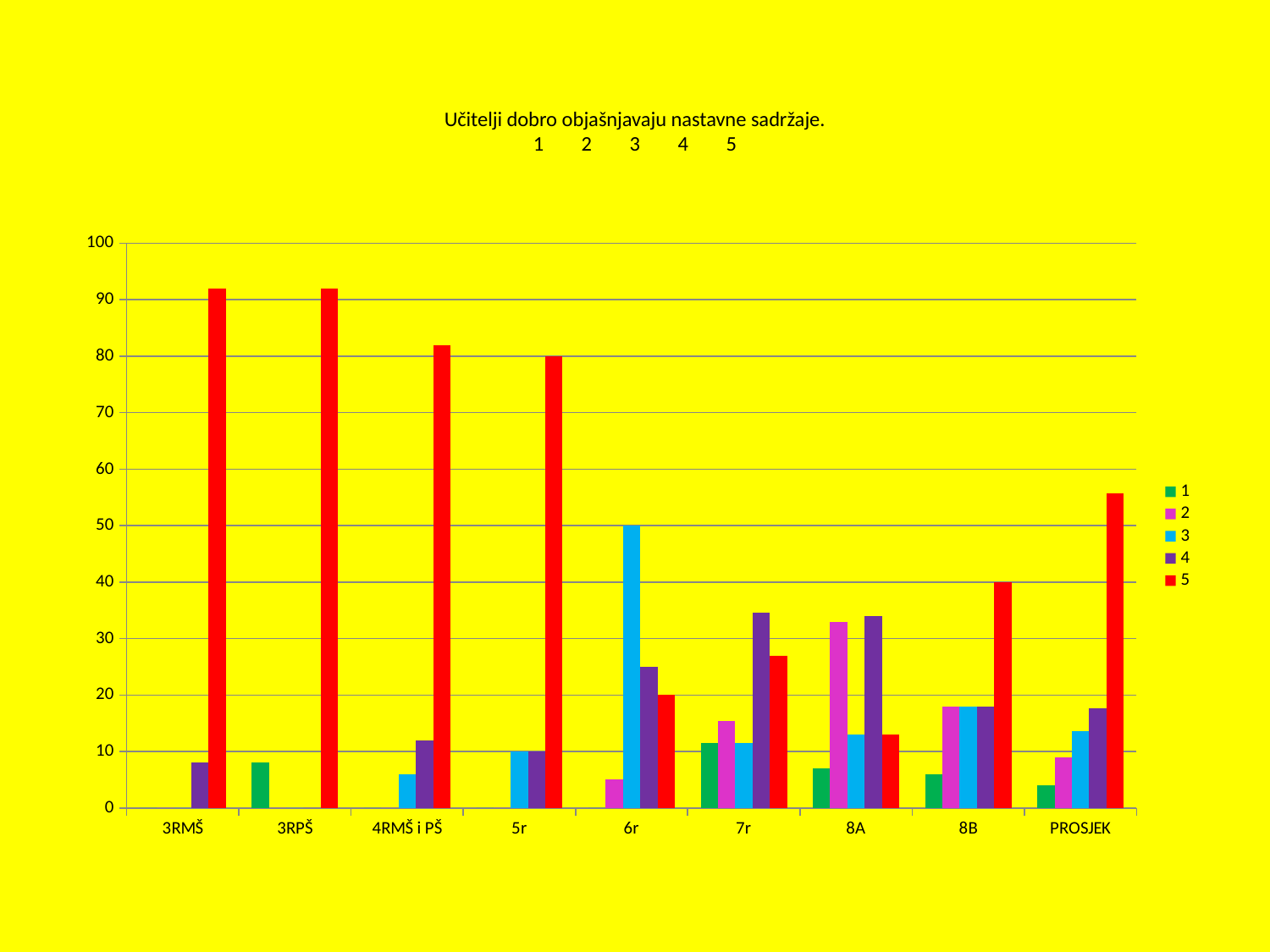
What is the value of series 5 for 5r? 80 Is the value of series 2 for 8A greater or less than 30? greater Which category has the lowest value for series 5? 8A What is the value of series 3 for 6r? 50 Which is larger, the value of series 3 for 6r or for 7r? 6r How many series does the legend list? 5 Is the value of series 5 for PROSJEK greater or less than 50? greater Is the value of series 5 for 3RMŠ greater or less than 90? greater What kind of chart is shown on the slide? bar chart What is the title of the chart? Učitelji dobro objašnjavaju nastavne sadržaje. What is the value of series 5 for 8B? 40 How many categories are shown on the x axis? 9